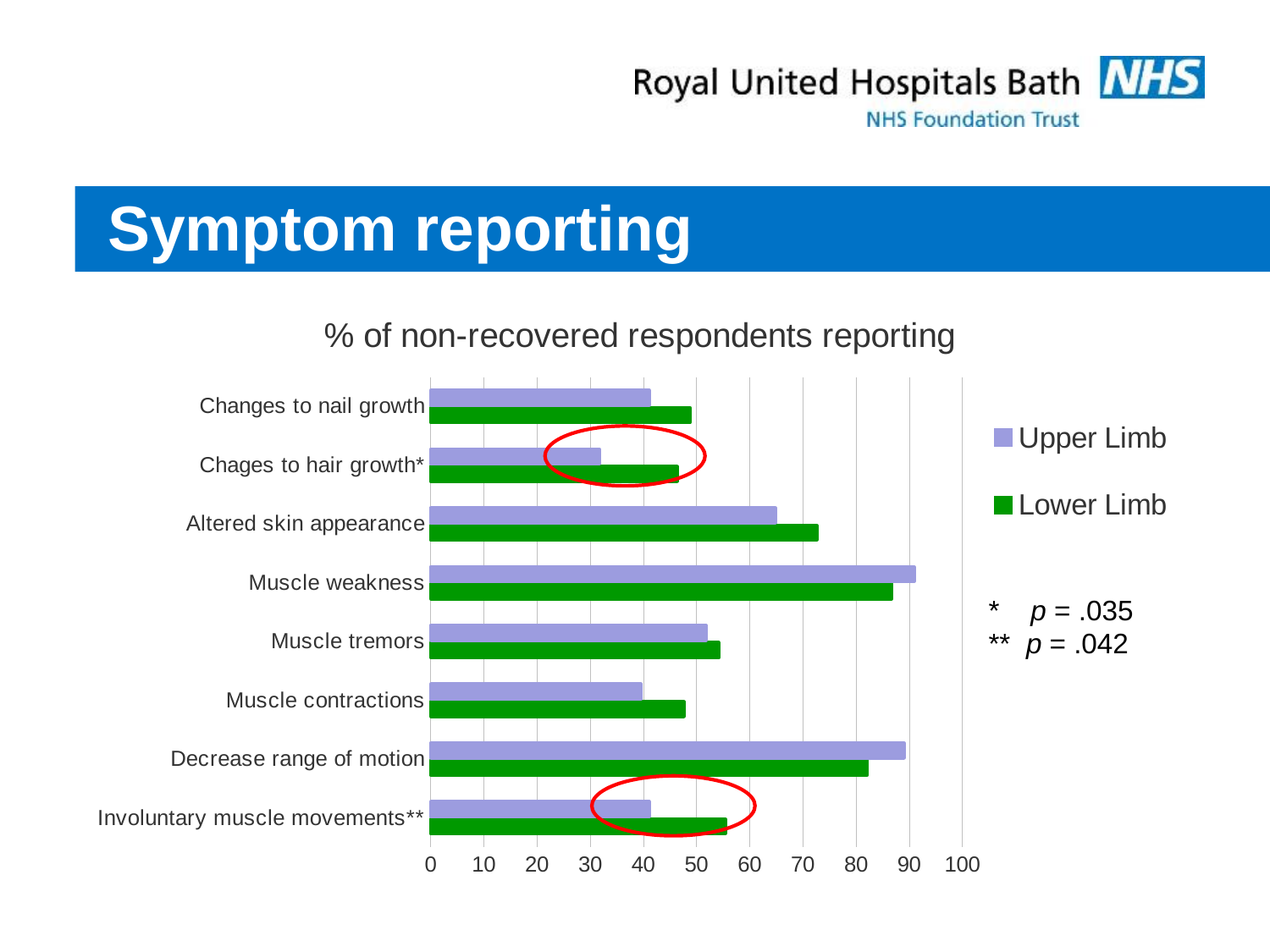
What is the title of the chart? % of non-recovered respondents reporting Which symptom has the lowest Upper Limb value? Chages to hair growth* Is the Upper Limb value for Chages to hair growth* greater or less than 40? less For Altered skin appearance, which is larger: the Upper Limb value or the Lower Limb value? Lower Limb Is the Lower Limb value for Altered skin appearance greater or less than 70? greater Is the Upper Limb value for Muscle weakness greater or less than 80? greater How many series does the chart legend list? 2 Which symptom has the highest Lower Limb value? Muscle weakness Which colour represents the Lower Limb series in the chart? Green How many symptom categories are plotted on the chart? 8 What kind of chart is shown on the slide? Bar chart For Decrease range of motion, which is larger: the Upper Limb value or the Lower Limb value? Upper Limb